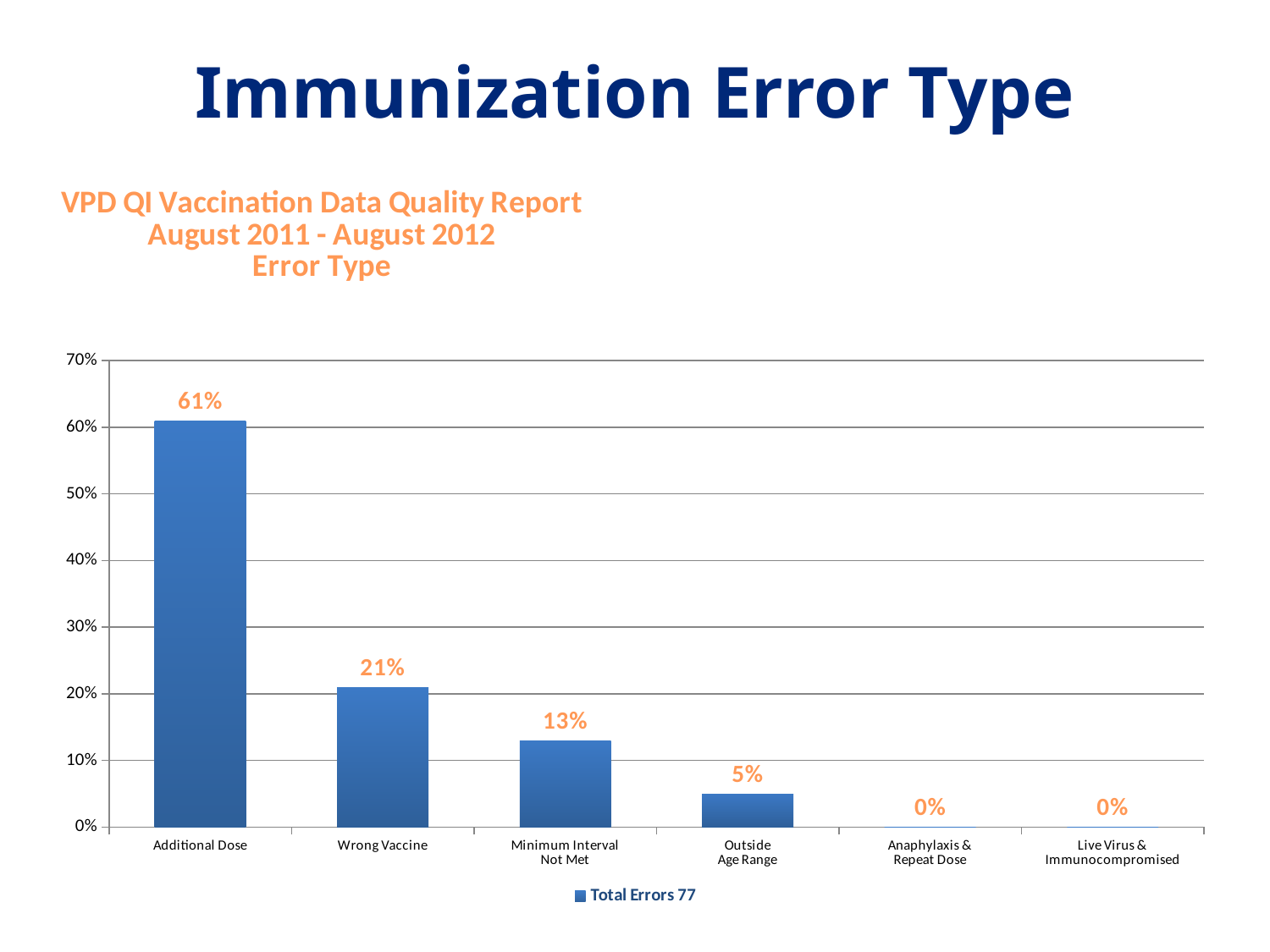
Which error type has the highest value? Additional Dose What is the legend entry shown below the chart? Total Errors 77 How many error type categories are shown on the x axis? 6 How many series does the legend list? 1 What kind of chart is shown on the slide? Bar chart What is the value for Anaphylaxis & Repeat Dose? 0% What is the value for Outside Age Range? 5% What is the difference between the values for Additional Dose and Wrong Vaccine? 40% What is the value for Additional Dose? 61% What is the value for Minimum Interval Not Met? 13% What is the value for Wrong Vaccine? 21% Which is larger, the value for Wrong Vaccine or the value for Minimum Interval Not Met? Wrong Vaccine